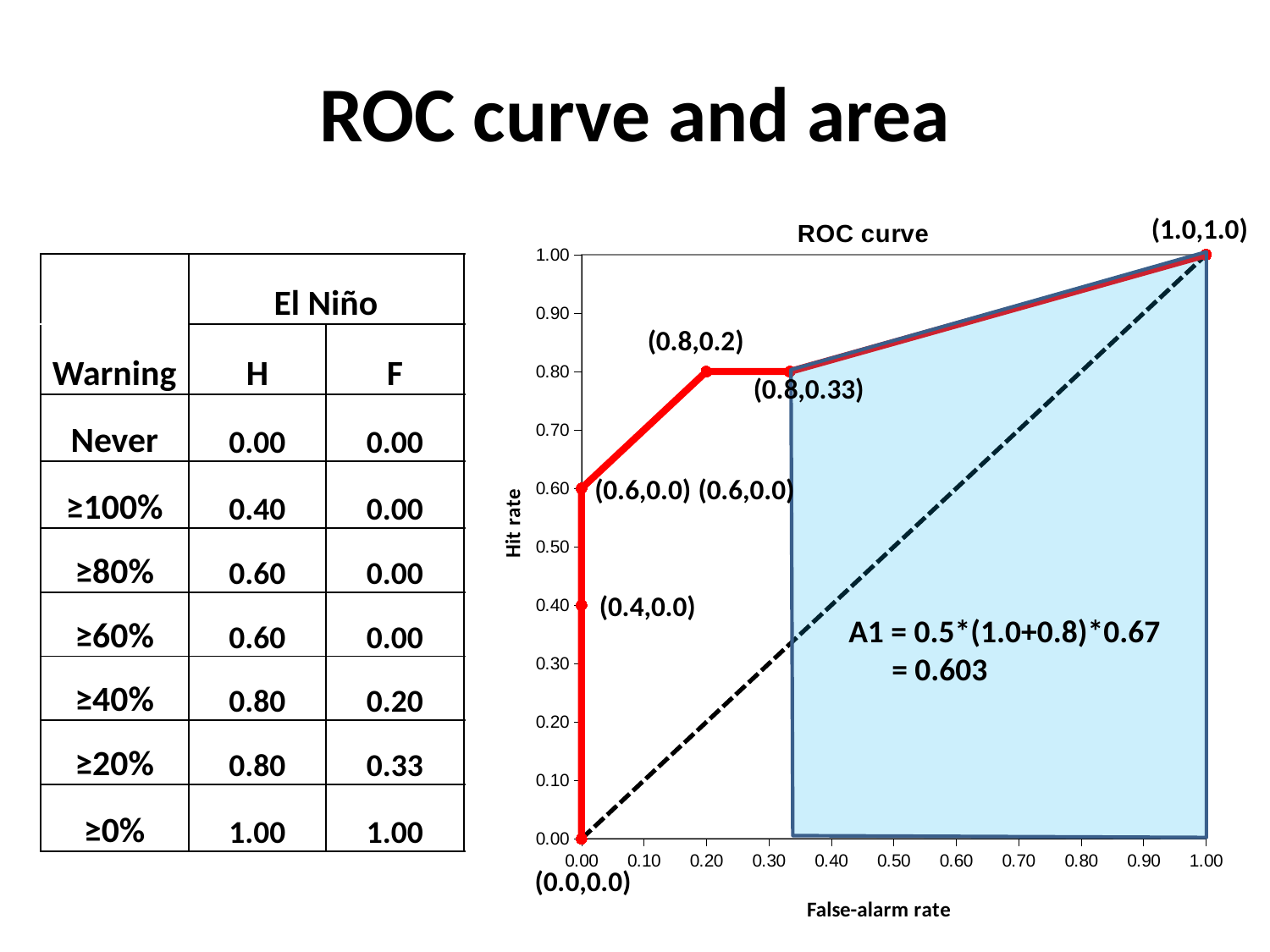
What is the title of the chart? ROC curve According to the point label on the ROC curve, what is the hit rate when the false-alarm rate is 0.2? 0.8 What is the maximum value shown on the y axis (Hit rate) of the chart? 1.00 What is the highest hit rate reached by the ROC curve? 1.0 What is the value of the area A1 printed on the chart? 0.603 Is the hit rate of the ROC curve at a false-alarm rate of 0.20 greater or less than 0.50? greater What is the label of the x axis of the ROC curve chart? False-alarm rate What kind of chart is shown on the slide? line chart Does the hit rate on the ROC curve rise or fall as the false-alarm rate increases from 0.00 to 1.00? rise Which is larger on the ROC curve: the hit rate at false-alarm rate 0.2 or the hit rate at false-alarm rate 1.0? the hit rate at false-alarm rate 1.0 What is the difference between the hit rate at false-alarm rate 1.0 and the hit rate at false-alarm rate 0.2 on the ROC curve? 0.2 According to the point label on the ROC curve, what is the hit rate when the false-alarm rate is 0.33? 0.8